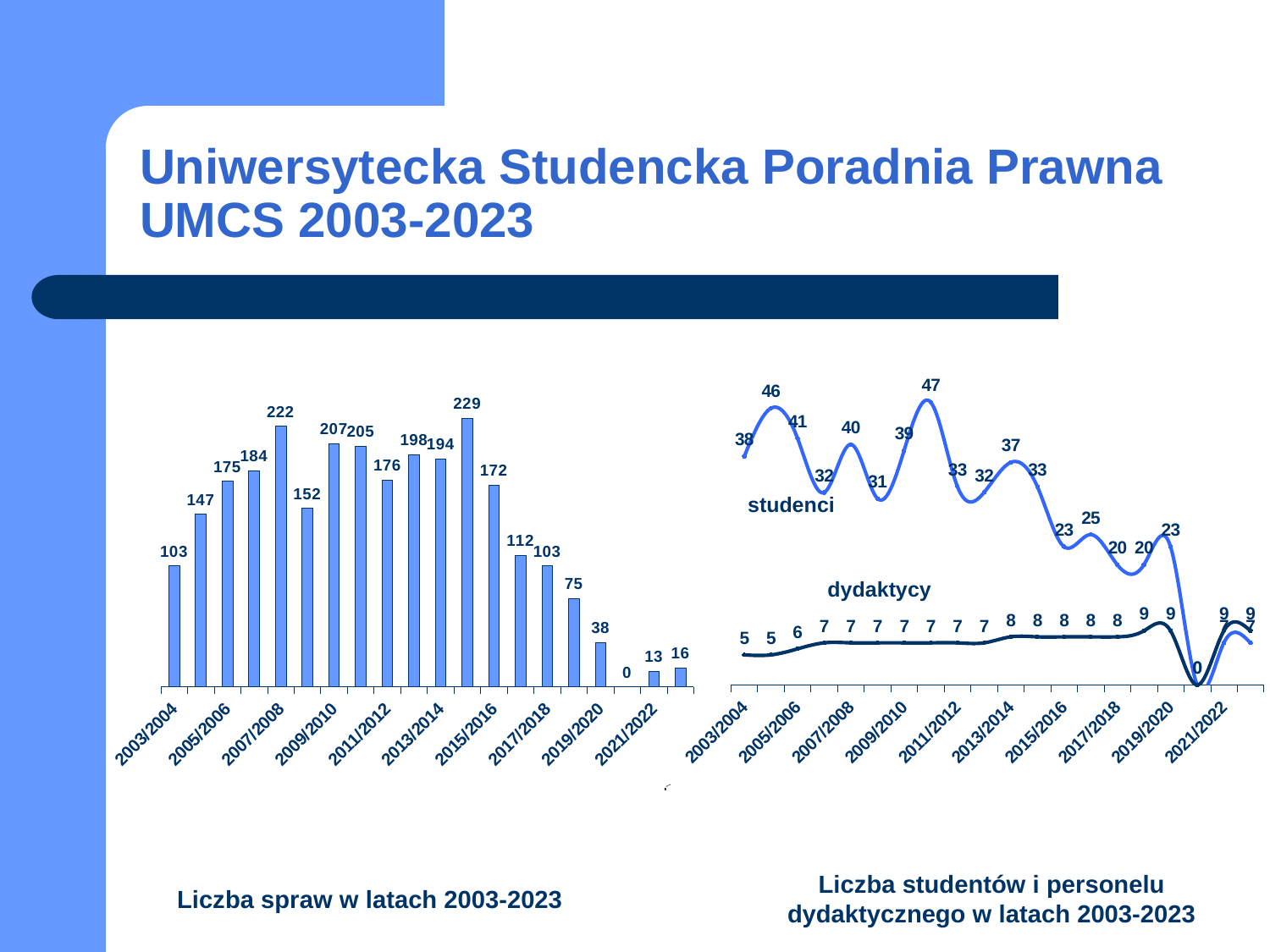
In the right chart 'Liczba studentów i personelu dydaktycznego w latach 2003-2023', what is the value of the dydaktycy series for 2007/2008? 7 How many series are plotted in the right chart 'Liczba studentów i personelu dydaktycznego w latach 2003-2023'? 2 In the left chart 'Liczba spraw w latach 2003-2023', what is the difference between the values for 2007/2008 and 2003/2004? 119 How many bars are in the left chart 'Liczba spraw w latach 2003-2023'? 20 In the right chart 'Liczba studentów i personelu dydaktycznego w latach 2003-2023', what is the difference between the studenci and dydaktycy values for 2003/2004? 33 In the left chart 'Liczba spraw w latach 2003-2023', what is the value for 2007/2008? 222 In the left chart 'Liczba spraw w latach 2003-2023', what is the lowest value shown? 0 What kind of chart is the left chart, 'Liczba spraw w latach 2003-2023'? bar chart In the left chart 'Liczba spraw w latach 2003-2023', which has the larger value, 2009/2010 or 2011/2012? 2009/2010 In the left chart 'Liczba spraw w latach 2003-2023', what is the value for 2003/2004? 103 In the left chart 'Liczba spraw w latach 2003-2023', what is the highest value shown? 229 In the right chart 'Liczba studentów i personelu dydaktycznego w latach 2003-2023', what is the highest value of the studenci series? 47